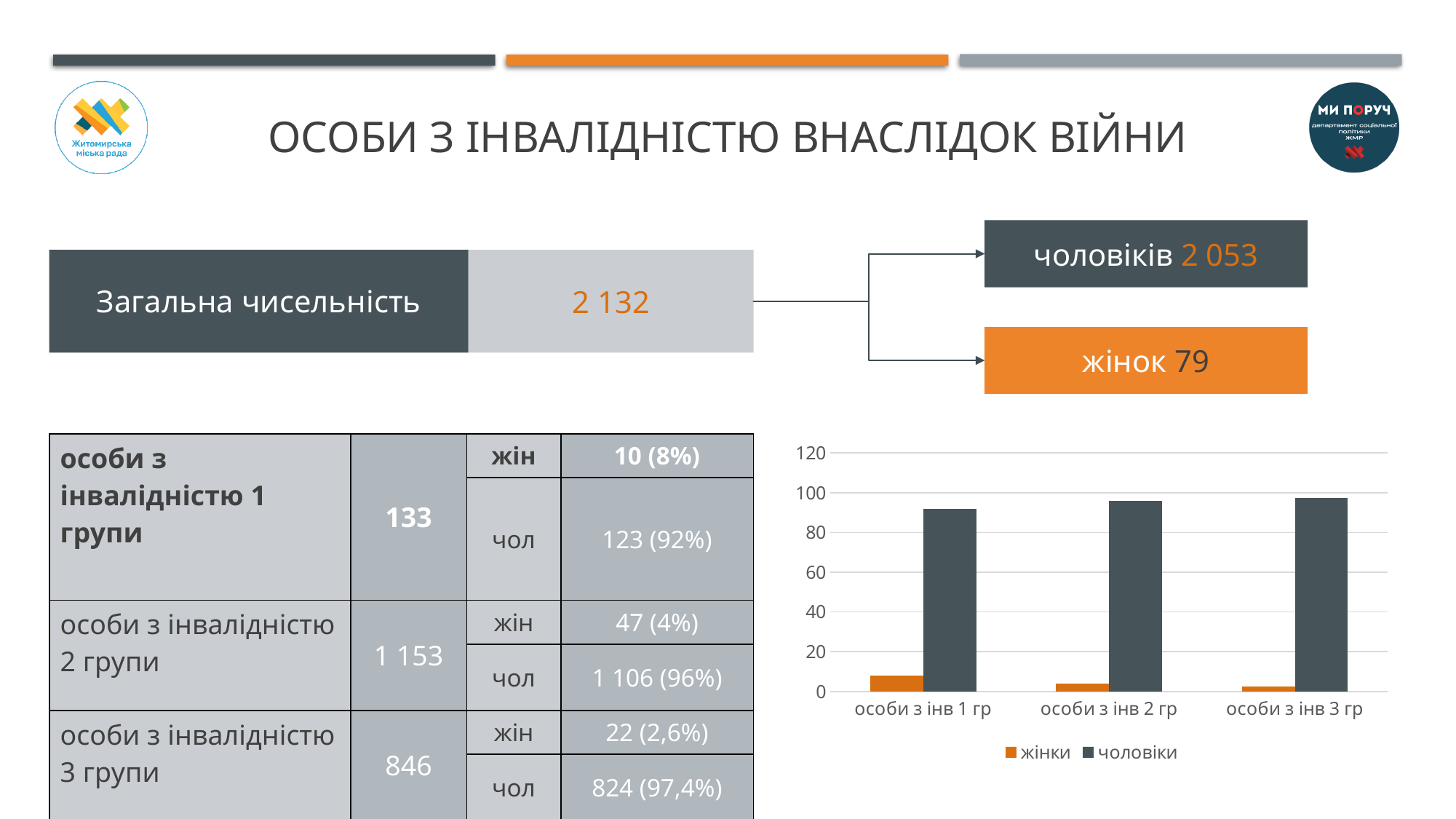
Which series in the bar chart is drawn in orange? жінки In the bar chart, is the value for жінки in особи з інв 3 гр greater or less than 20? less What kind of chart is shown on the right side of the slide? bar chart In the bar chart, do the values for жінки rise or fall from особи з інв 1 гр to особи з інв 3 гр? fall In the bar chart, is the value for чоловіки in особи з інв 1 гр greater or less than 80? greater In the bar chart, which is larger for особи з інв 2 гр: жінки or чоловіки? чоловіки In the bar chart, is the value for жінки in особи з інв 1 гр greater or less than 20? less What are the two legend entries of the bar chart? жінки, чоловіки How many categories are shown on the x axis of the bar chart? 3 How many series does the legend of the bar chart list? 2 In the bar chart, which category has the highest value for жінки? особи з інв 1 гр